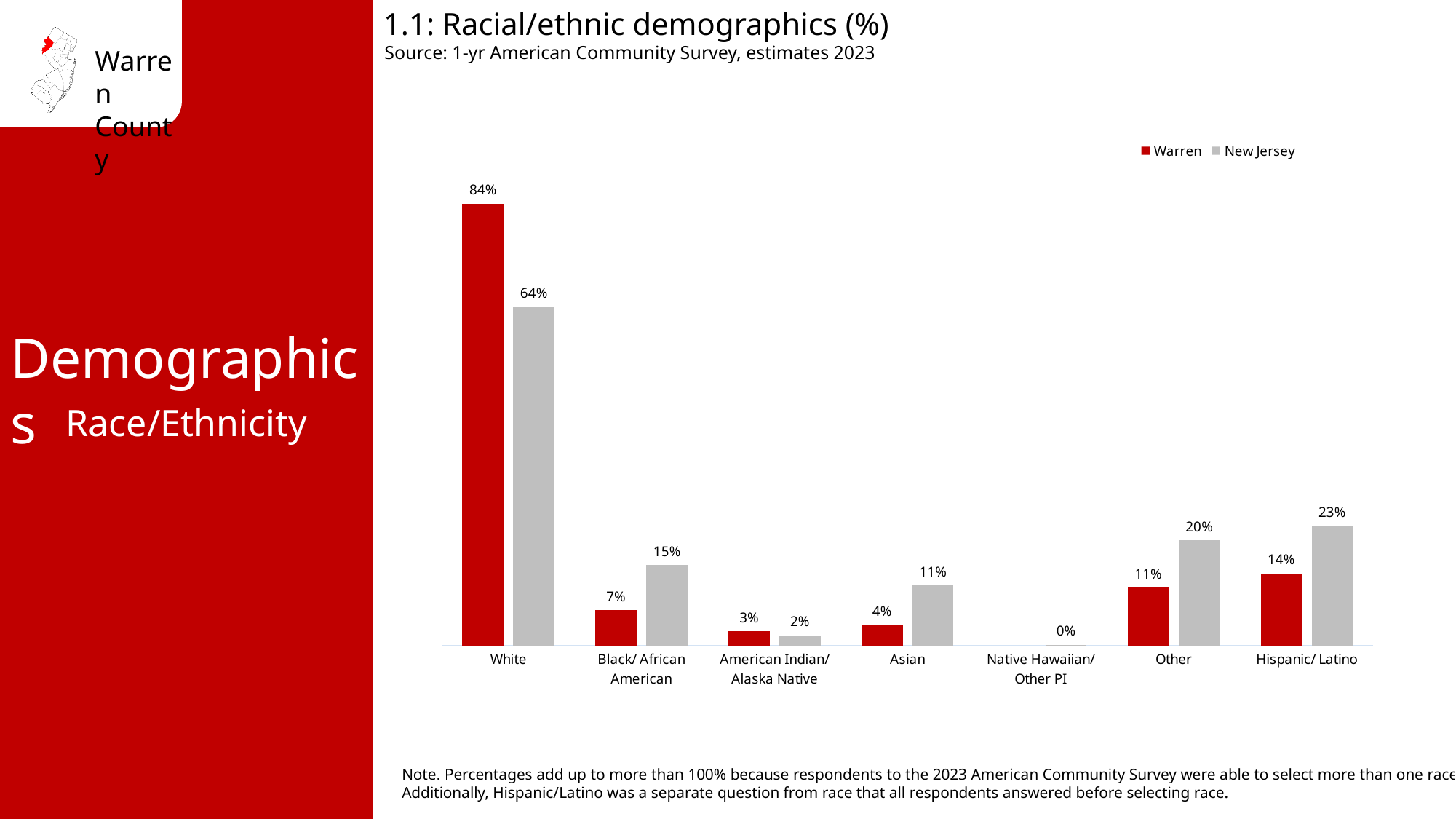
What is the Warren value for White? 84% Which is larger for American Indian/ Alaska Native, the Warren value or the New Jersey value? Warren How many series does the legend list? 2 What kind of chart is shown on the slide? Bar chart What is the Warren value for Hispanic/ Latino? 14% How many categories are shown on the x axis? 7 What is the New Jersey value for Black/ African American? 15% What is the New Jersey value for Asian? 11% Which category has the lowest New Jersey value? Native Hawaiian/ Other PI What is the difference between the New Jersey and Warren values for Other? 9% Which category has the highest Warren value? White What is the difference between the Warren and New Jersey values for White? 20%